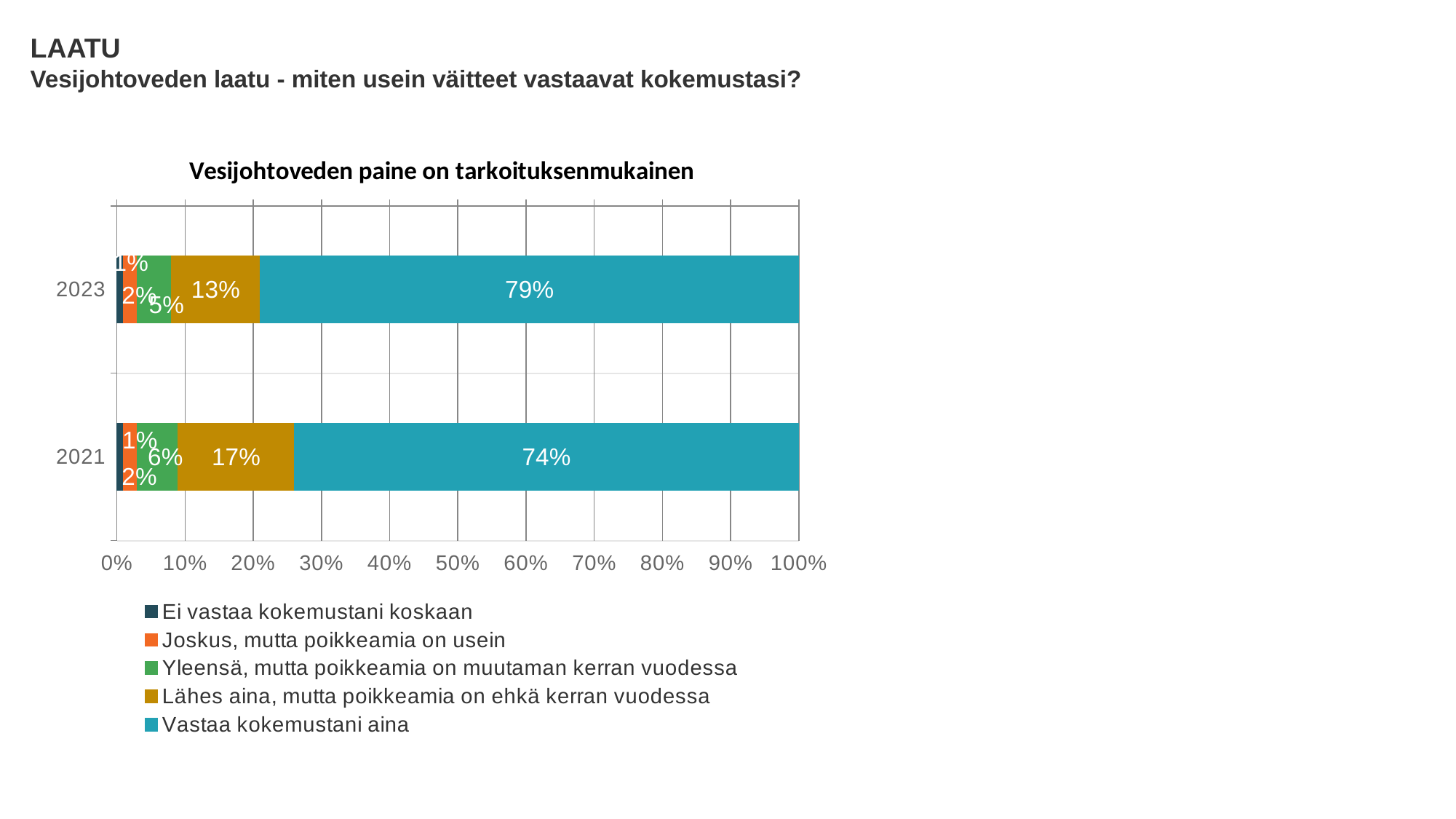
What is the value for 'Vastaa kokemustani aina' in 2021? 74% What is the value for 'Lähes aina, mutta poikkeamia on ehkä kerran vuodessa' in 2021? 17% Which year has the higher value for 'Vastaa kokemustani aina', 2023 or 2021? 2023 What kind of chart is shown on the slide? Stacked bar chart Which series has the largest share in the 2021 bar? Vastaa kokemustani aina What is the value for 'Vastaa kokemustani aina' in 2023? 79% What is the difference between the 'Lähes aina, mutta poikkeamia on ehkä kerran vuodessa' values for 2021 and 2023? 4% Is the value for 'Vastaa kokemustani aina' in 2021 greater or less than 70%? greater What is the title of the chart? Vesijohtoveden paine on tarkoituksenmukainen How many series does the legend list? 5 How many years (categories) are plotted on the chart? 2 What is the value for 'Yleensä, mutta poikkeamia on muutaman kerran vuodessa' in 2023? 5%